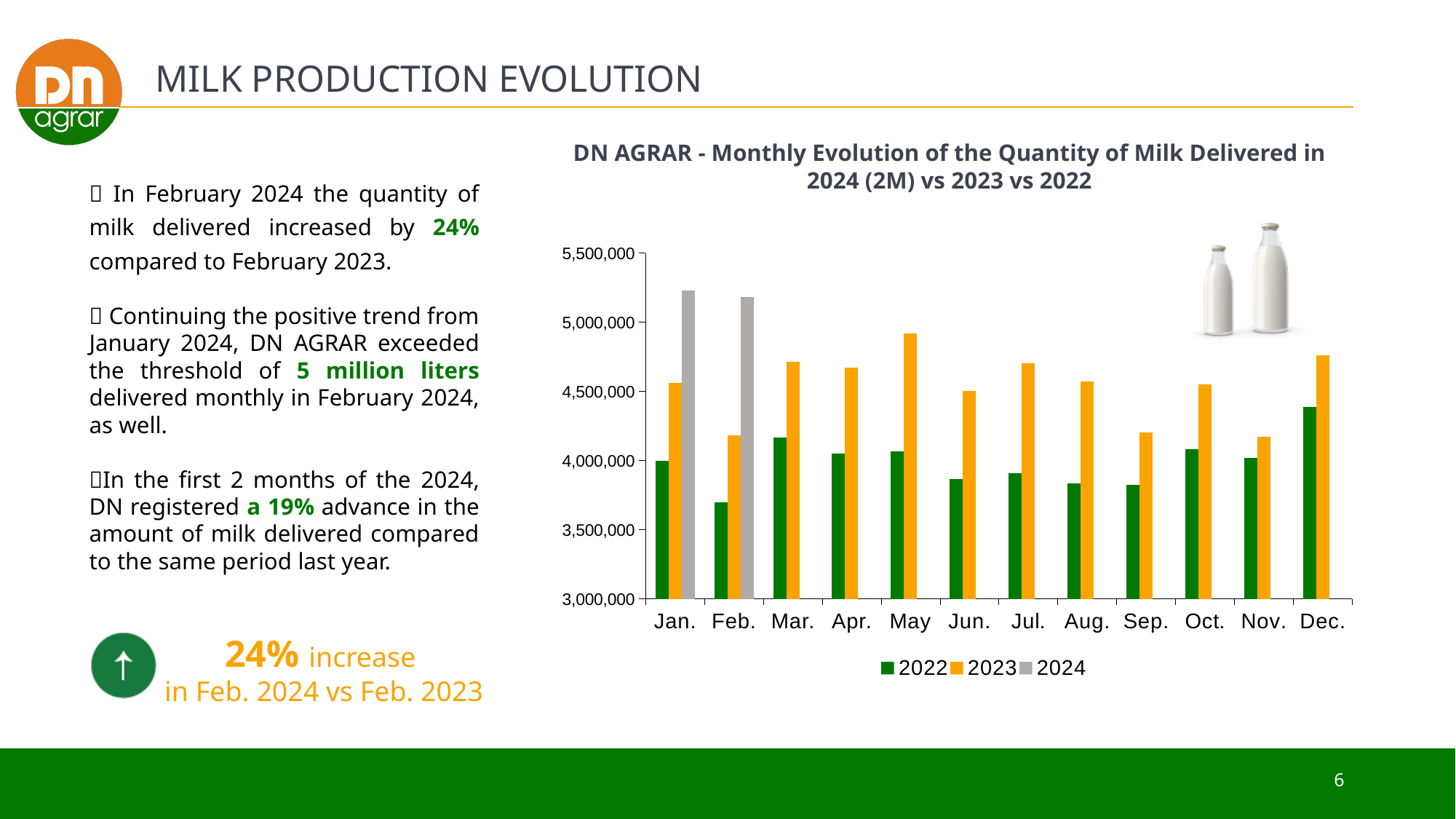
In which month is the 2022 series highest? Dec. In Jan., which series has the larger value, 2023 or 2024? 2024 Which colour represents the 2024 series in the chart legend? grey In which month is the 2023 series highest? May Is the value for 2022 in Feb. greater or less than 4,000,000? less What kind of chart is shown on the slide? bar chart How many series does the chart legend list? 3 In which month is the 2022 series lowest? Feb. How many months are shown on the x axis of the chart? 12 Is the value for 2024 in Jan. greater or less than 5,000,000? greater Is the value for 2023 in Jun. greater or less than 4,000,000? greater